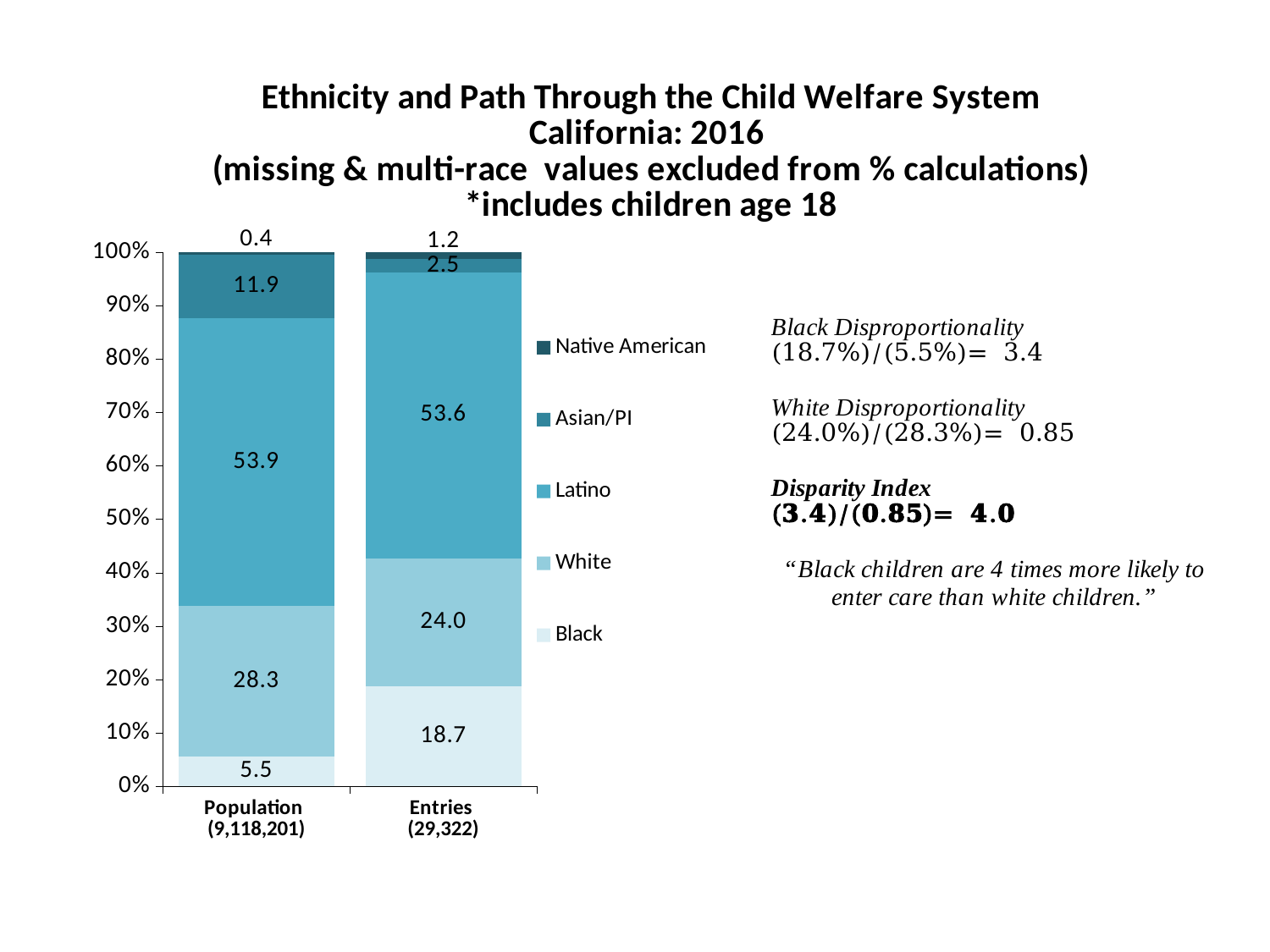
How many series does the legend list? 5 What is the value for Asian/PI in the Population bar? 11.9 How many bars are plotted in the chart? 2 What is the difference between the White value in the Population bar and the White value in the Entries bar? 4.3 What kind of chart is shown on the slide? Stacked bar chart What is the value for Latino in the Entries bar? 53.6 What is the value for Black in the Population bar? 5.5 Which series has the largest value in the Population bar? Latino What is the value for Black in the Entries bar? 18.7 Which is larger: the Black value in the Population bar or the Black value in the Entries bar? Entries Which series has the smallest value in the Entries bar? Native American What is the value for Native American in the Entries bar? 1.2